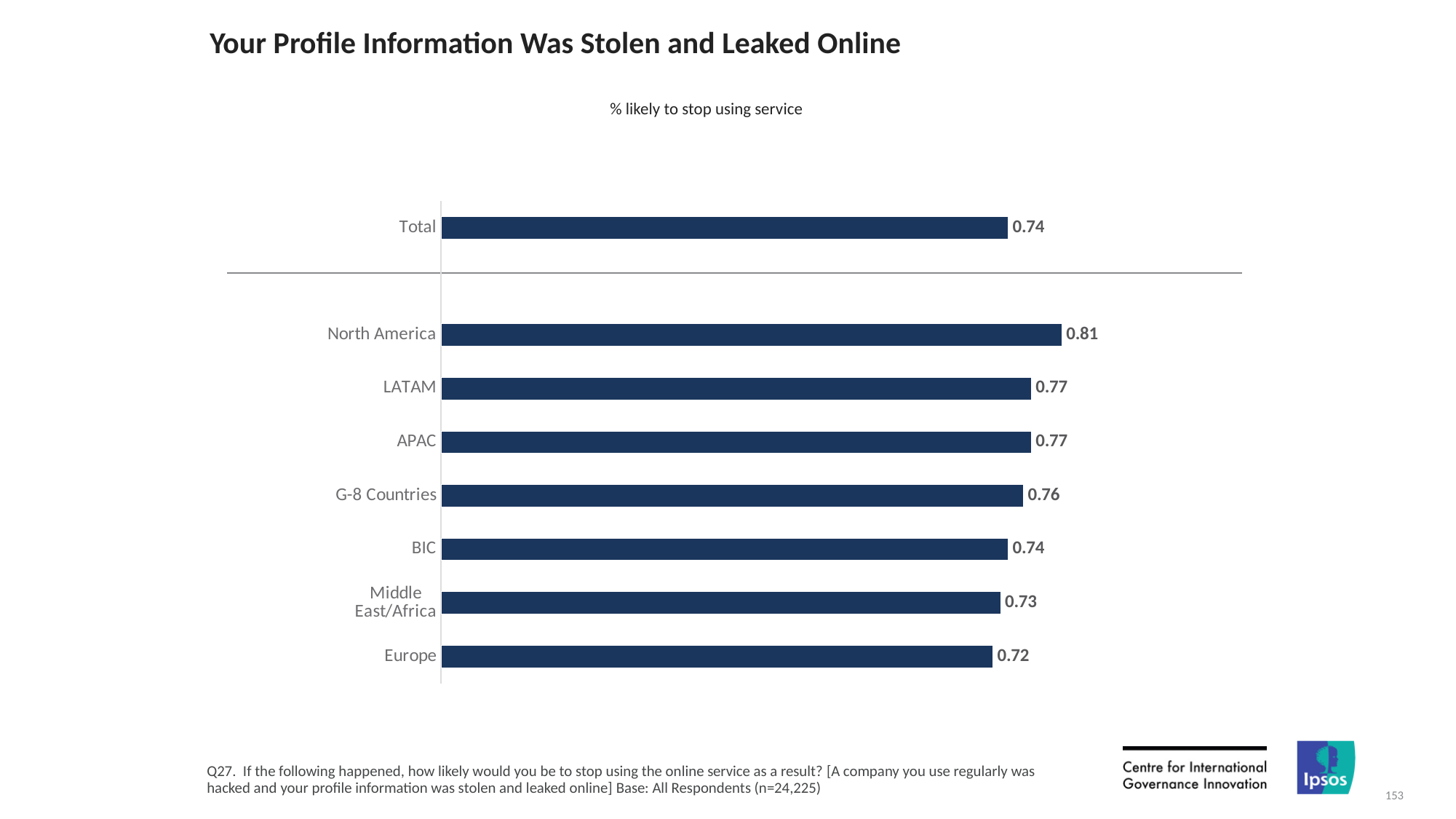
Which is larger, the value for North America or the value for LATAM? North America What is the difference between the values for G-8 Countries and BIC? 0.02 What is the value for Total? 0.74 What is the title of the chart? Your Profile Information Was Stolen and Leaked Online How many bars are plotted on the chart? 8 What is the value for Europe? 0.72 Which region has the highest value? North America What is the value for North America? 0.81 What is the difference between the values for North America and Europe? 0.09 What is the value for Middle East/Africa? 0.73 Which region has the lowest value? Europe What kind of chart is shown on the slide? Bar chart